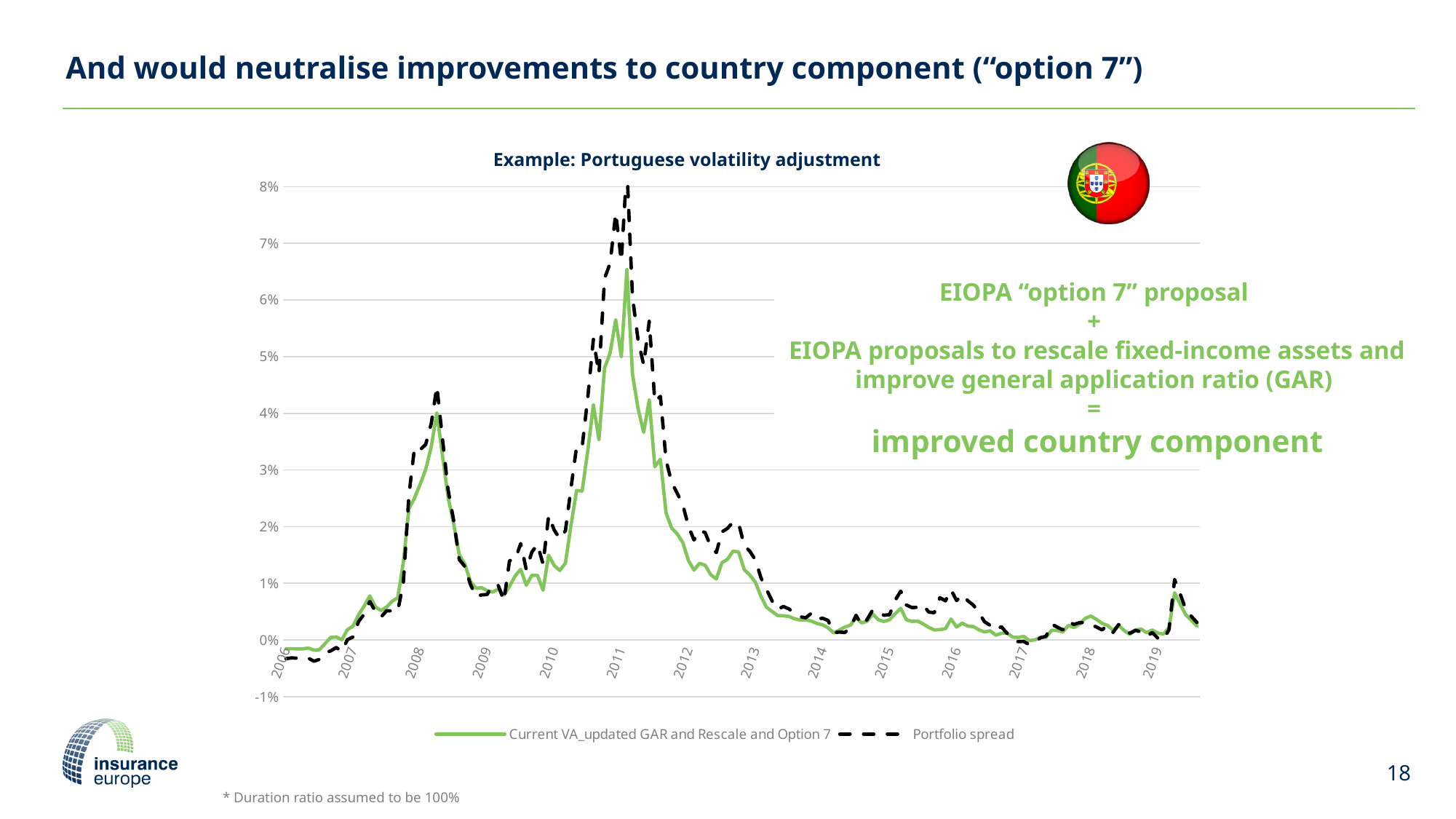
What is the title of the chart? Example: Portuguese volatility adjustment How many series does the chart legend list? 2 Is the value of the Portfolio spread series in 2017 greater or less than 1%? less How many year labels are shown on the x axis? 14 Is the peak value of the Current VA_updated GAR and Rescale and Option 7 series around 2008 greater or less than 5%? less What kind of chart is shown on the slide? line chart Is the peak value of the Portfolio spread series around 2011 greater or less than 7%? greater Do the values of the Portfolio spread series rise or fall between the 2011 peak and 2014? fall At the peak around 2011, which series reaches the higher value: Portfolio spread or Current VA_updated GAR and Rescale and Option 7? Portfolio spread Which series is drawn as a black dashed line? Portfolio spread